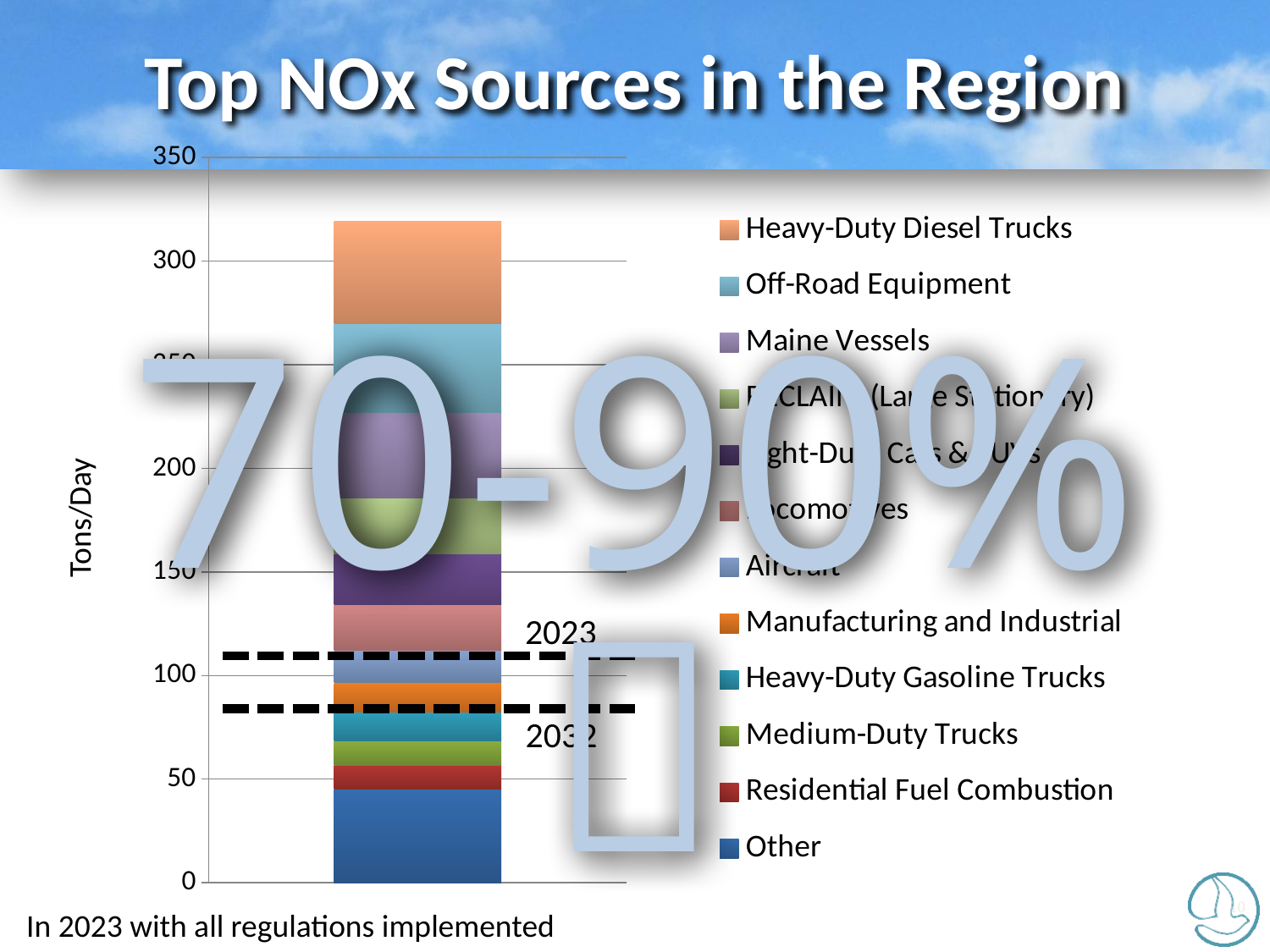
Is the total height of the stacked bar greater or less than 300? greater How many series does the legend list? 12 What kind of chart is shown on the slide? stacked bar chart Is the value for the Other segment greater or less than 50? less Is the total height of the stacked bar greater or less than 350? less How many bars are plotted in the chart? 1 Which series is listed first in the legend? Heavy-Duty Diesel Trucks What is the title of the chart on the slide? Top NOx Sources in the Region What is the label on the vertical axis? Tons/Day